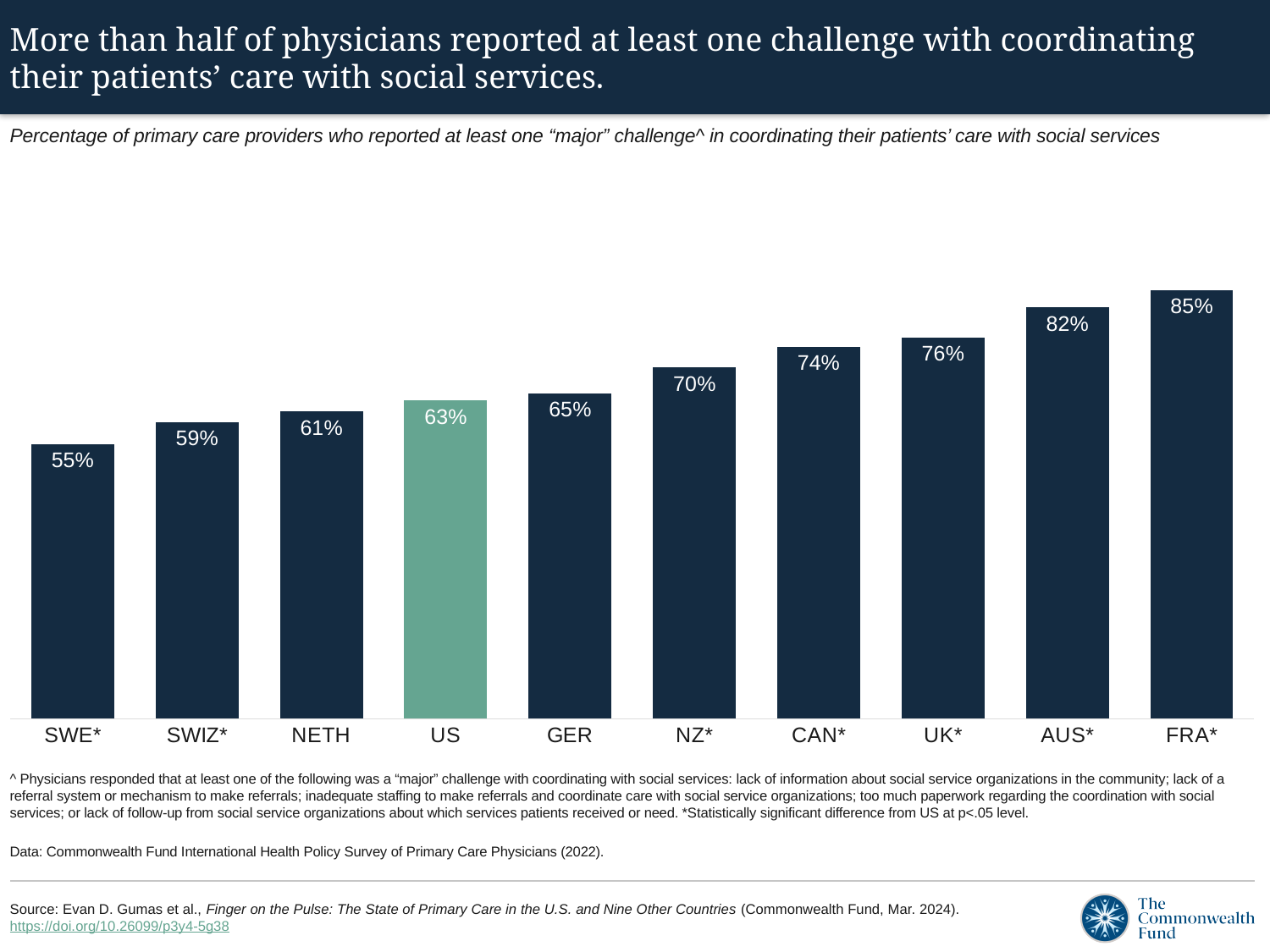
Which has a higher value, CAN* or GER? CAN* What type of chart is shown on the slide? Bar chart How many countries are shown in the chart? 10 What is the value shown for FRA*? 85% Do the values rise or fall moving from left to right across the chart? Rise Which country has the lowest percentage of providers reporting at least one major challenge? SWE* What is the value shown for NETH? 61% Which country has the highest percentage of providers reporting at least one major challenge? FRA* What is the difference in percentage points between AUS* and the US? 19 percentage points What percentage of primary care providers in the US reported at least one major challenge coordinating care with social services? 63% Which has a higher value, SWIZ* or UK*? UK* What is the difference in percentage points between FRA* and SWE*? 30 percentage points